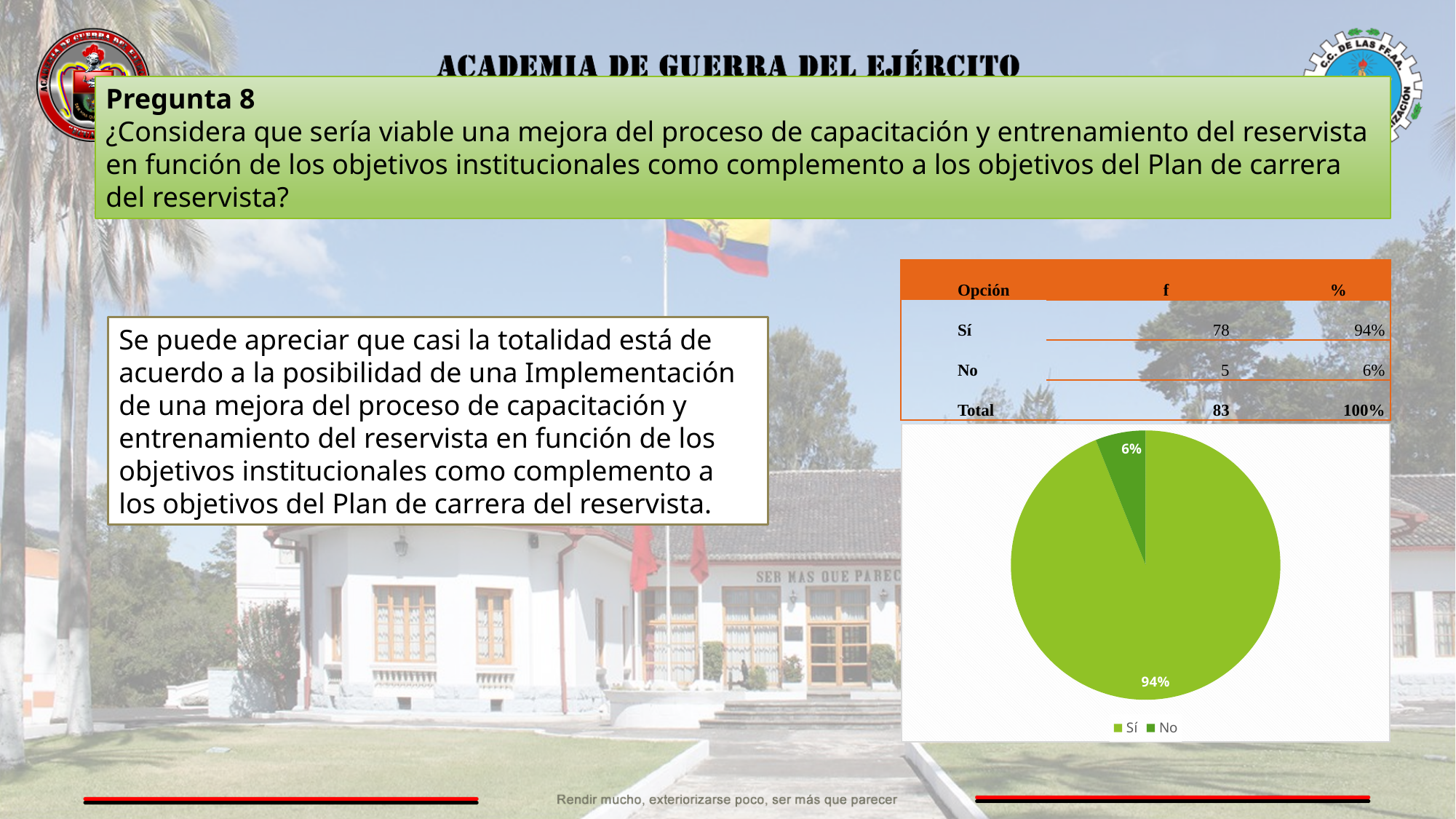
How many slices does the pie chart have? 2 What is the share of the "Sí" slice in the pie chart? 94% What is the difference in percentage points between the "Sí" and "No" slices? 88 Which colour is used for the "No" slice in the pie chart? dark green Which category has the largest slice in the pie chart? Sí What are the legend entries of the pie chart? Sí, No Which slice is larger, "Sí" or "No"? Sí How many entries does the legend of the pie chart list? 2 Which category has the smallest slice in the pie chart? No What percentage of the pie chart corresponds to "Sí"? 94% What percentage of the pie chart corresponds to "No"? 6% What kind of chart is shown on the slide? pie chart